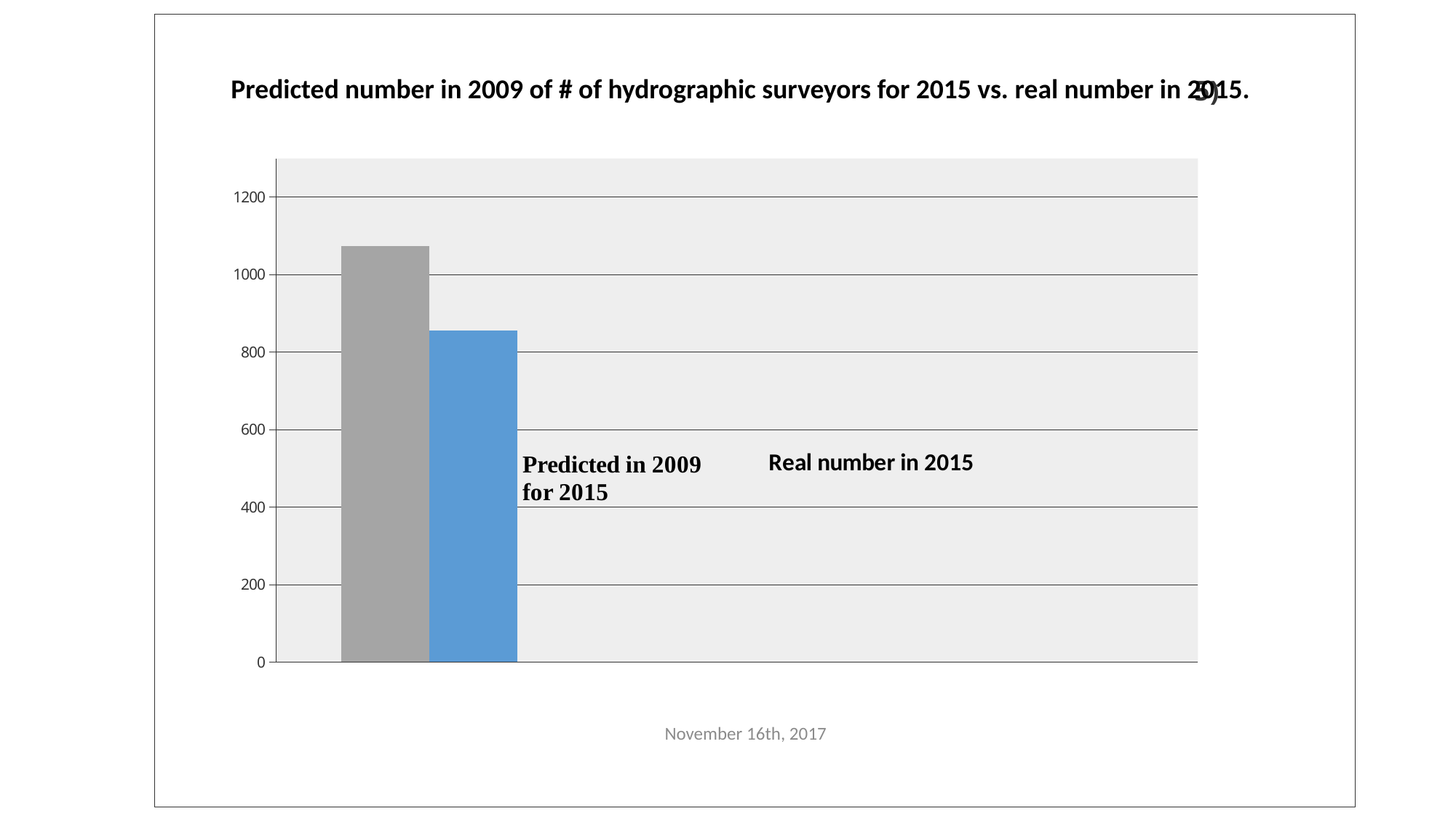
What date is printed at the bottom of the slide? November 16th, 2017 Is the value of the blue bar greater or less than 1000? less Which bar is taller, the gray bar or the blue bar? the gray bar What is the highest tick value shown on the vertical axis? 1200 What kind of chart is shown on the slide? bar chart Is the value of the gray bar greater or less than 1200? less Which bar has the highest value in the chart? the gray bar How many bars are plotted in the chart? 2 Is the value of the blue bar greater or less than 800? greater Which bar has the lowest value in the chart? the blue bar